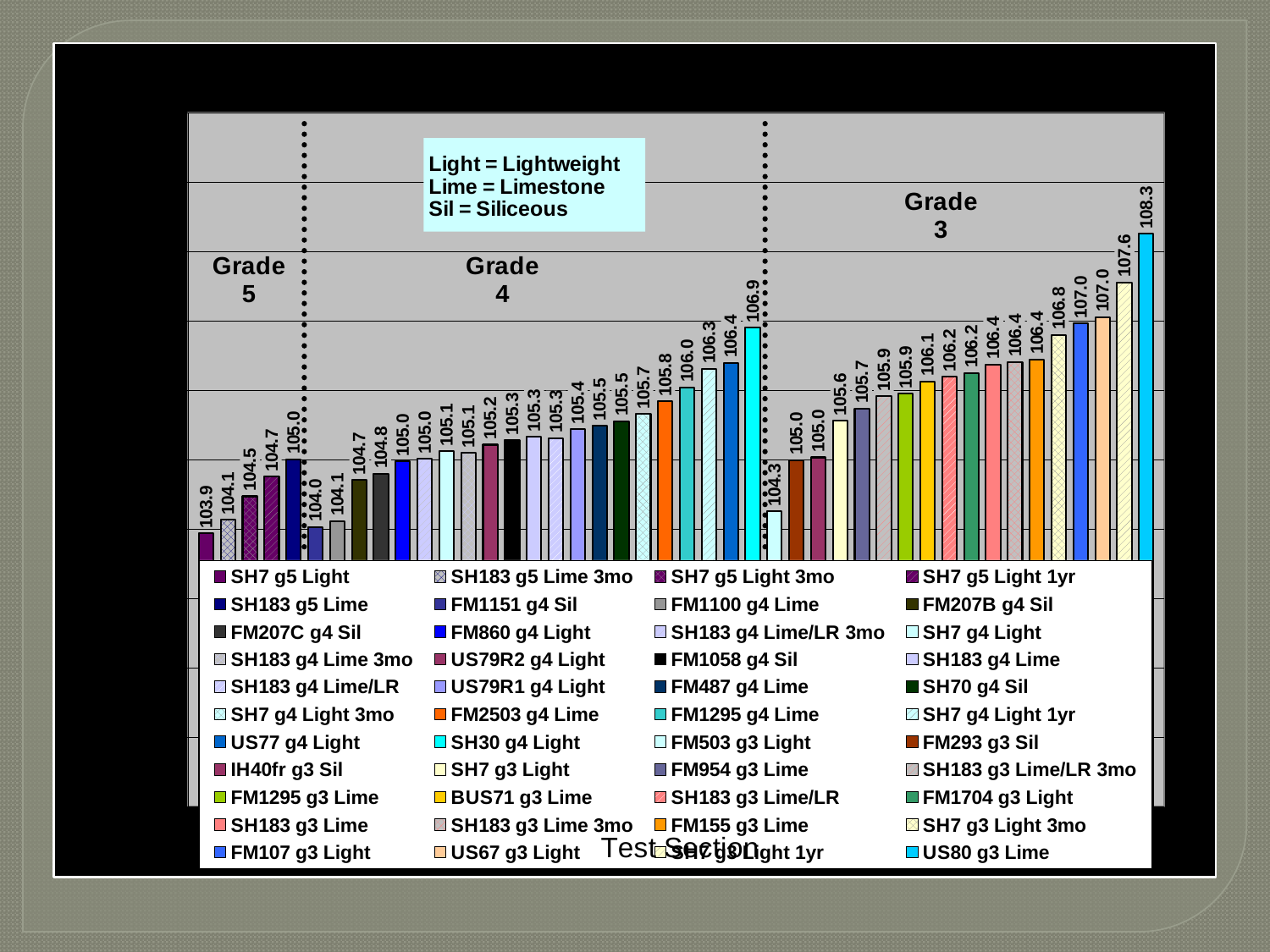
How many entries does the legend list? 44 According to the text box on the chart, what does "Sil" stand for? Siliceous What is the difference between the highest bar value (108.3) and the lowest bar value (103.9)? 4.4 What is the highest value labelled on any bar in the chart? 108.3 What is the value of the tallest bar in the Grade 4 group? 106.9 How many bars are plotted in the chart? 44 What is the value of the tallest bar in the Grade 5 group? 105.0 Which group has the taller maximum bar, Grade 4 or Grade 3? Grade 3 What is the value of the shortest bar in the Grade 3 group? 104.3 What kind of chart is shown on the slide? bar chart What is the value labelled on the bar for US80 g3 Lime? 108.3 What is the lowest value labelled on any bar in the chart? 103.9